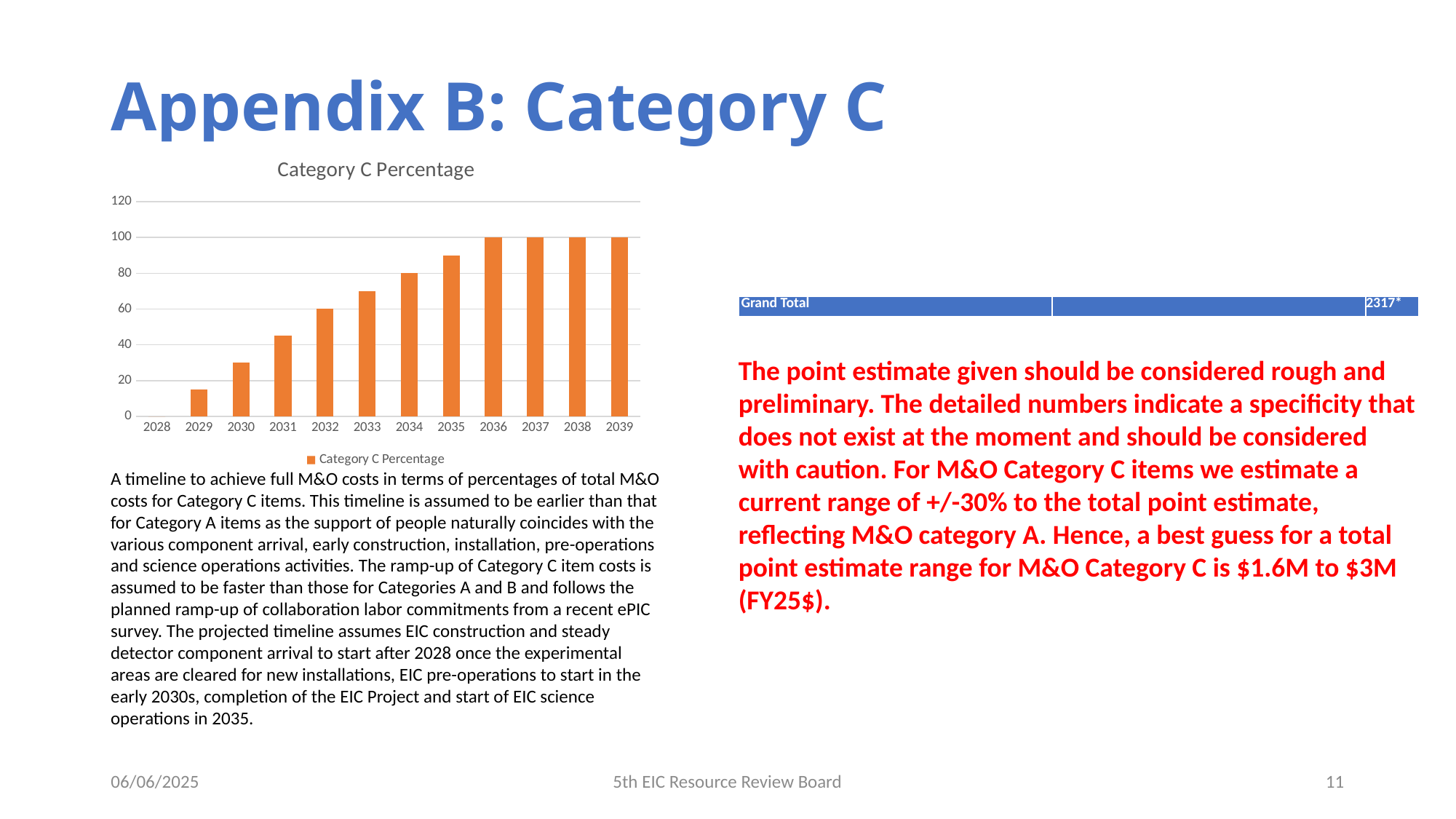
Is the value for 2029 greater or less than 20? less Which year has a higher Category C Percentage, 2030 or 2033? 2033 Do the values rise or fall from 2028 to 2036? rise Is the value for 2031 greater or less than 40? greater What type of chart is shown on the slide? bar chart Which year has the lowest Category C Percentage? 2028 How many years are shown on the x axis of the chart? 12 How many series does the chart legend list? 1 What is the Category C Percentage value for 2036? 100 What is the Category C Percentage value for 2034? 80 What is the Category C Percentage value for 2032? 60 What is the title of the chart? Category C Percentage